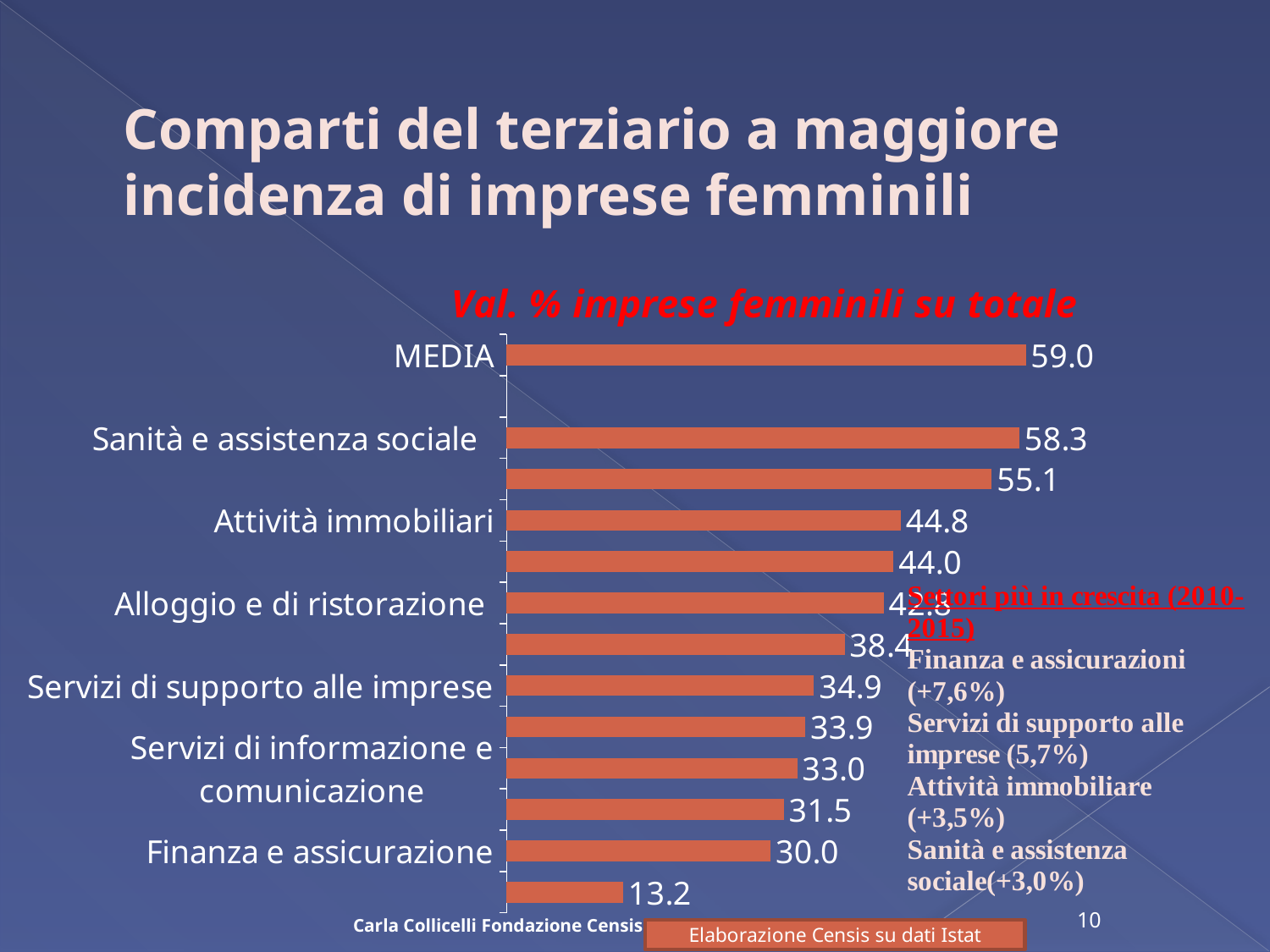
What type of chart is shown on the slide? Bar chart What is the value for Finanza e assicurazione? 30.0 What is the value for Sanità e assistenza sociale? 58.3 What is the value for Attività immobiliari? 44.8 Which labeled category has the highest value in the chart? MEDIA Which is larger, the value for Attività immobiliari or the value for Servizi di supporto alle imprese? Attività immobiliari What is the smallest value shown on the chart? 13.2 What is the value for Servizi di supporto alle imprese? 34.9 How many bars are plotted in the chart? 13 What is the value for Servizi di informazione e comunicazione? 33.0 What is the difference between the values for Sanità e assistenza sociale and Finanza e assicurazione? 28.3 What is the value for MEDIA in the chart? 59.0